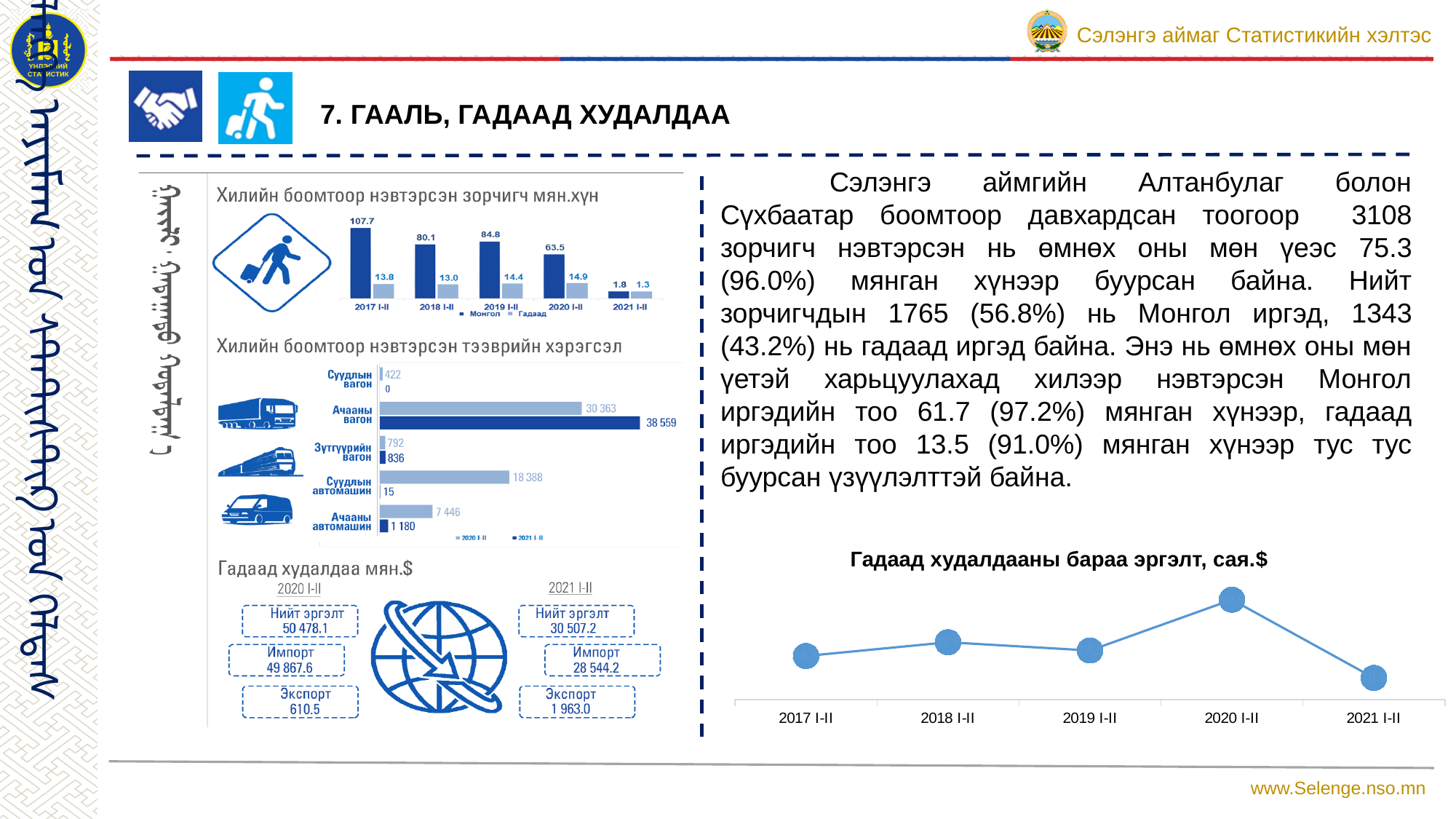
In the chart 'Хилийн боомтоор нэвтэрсэн зорчигч мян.хүн', how many periods are shown on the x axis? 5 What kind of chart is 'Гадаад худалдааны бараа эргэлт, сая.$'? line chart In the chart 'Гадаад худалдааны бараа эргэлт, сая.$', which period has the lowest value? 2021 I-II In the chart 'Хилийн боомтоор нэвтэрсэн зорчигч мян.хүн', how many series does the legend list? 2 In the chart 'Хилийн боомтоор нэвтэрсэн тээврийн хэрэгсэл', what is the value for Суудлын автомашин in 2020 I-II? 18 388 In the chart 'Хилийн боомтоор нэвтэрсэн зорчигч мян.хүн', what is the value for Гадаад in 2020 I-II? 14.9 In the chart 'Хилийн боомтоор нэвтэрсэн тээврийн хэрэгсэл', which period has the larger value for Зүтгүүрийн вагон, 2020 I-II or 2021 I-II? 2021 I-II In the chart 'Хилийн боомтоор нэвтэрсэн зорчигч мян.хүн', what is the difference between the Монгол and Гадаад values in 2019 I-II? 70.4 In the chart 'Гадаад худалдааны бараа эргэлт, сая.$', which period has the highest value? 2020 I-II In the chart 'Хилийн боомтоор нэвтэрсэн тээврийн хэрэгсэл', what is the value for Ачааны вагон in 2021 I-II? 38 559 In the chart 'Хилийн боомтоор нэвтэрсэн зорчигч мян.хүн', what is the value for Монгол in 2017 I-II? 107.7 In the chart 'Хилийн боомтоор нэвтэрсэн зорчигч мян.хүн', which period has the highest value for Монгол? 2017 I-II